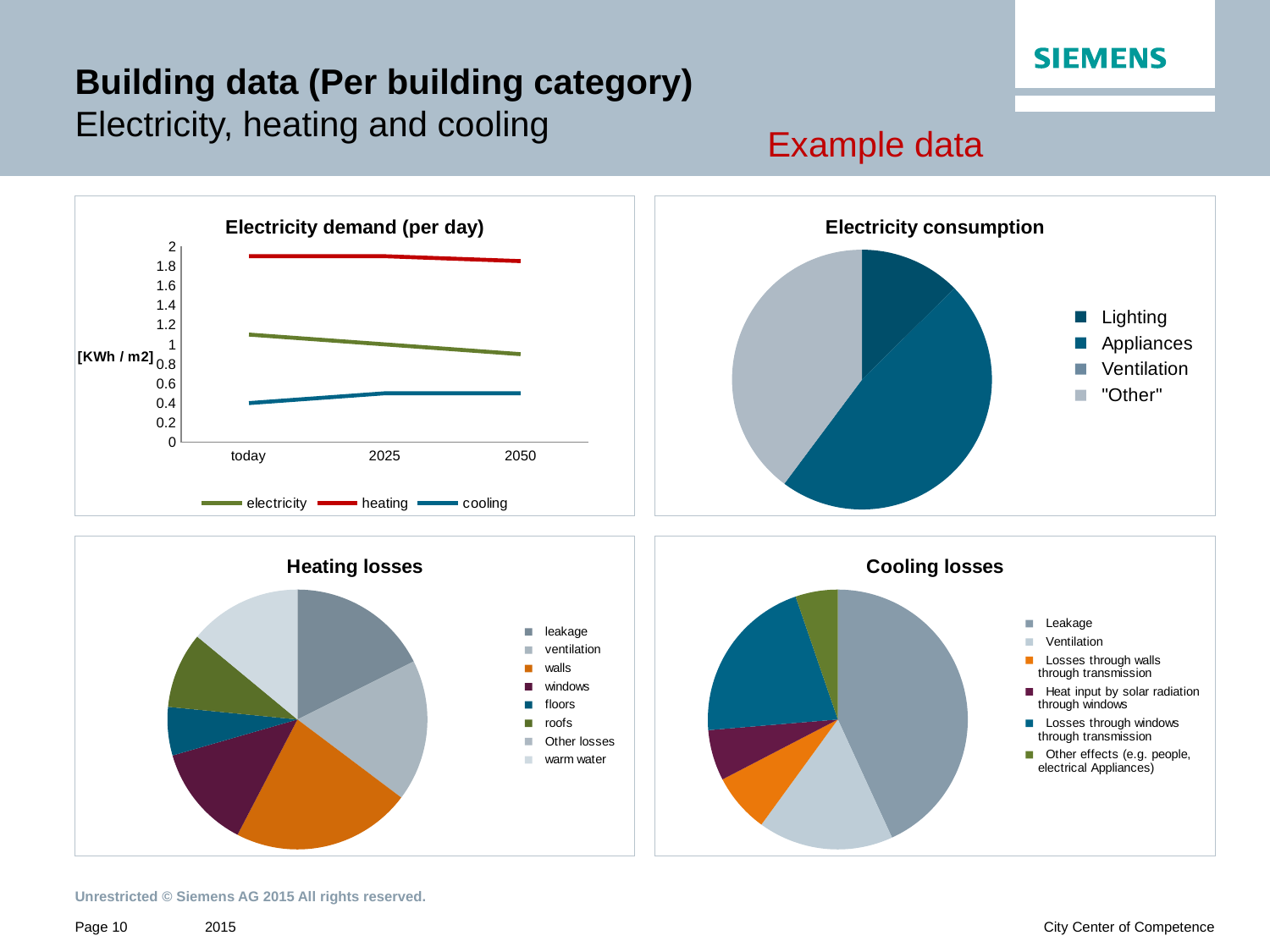
In the 'Cooling losses' pie chart, which category has the largest slice? Leakage In the 'Heating losses' pie chart, how many categories does the legend list? 8 In the 'Electricity demand (per day)' chart, which series has the highest values? heating What kind of chart is the 'Electricity demand (per day)' chart? line chart In the 'Electricity consumption' pie chart, which is larger, Lighting or Appliances? Appliances In the 'Electricity demand (per day)' chart, how many series does the legend list? 3 In the 'Heating losses' pie chart, which category has the smallest slice? floors In the 'Electricity demand (per day)' chart, does the electricity series rise or fall from today to 2050? falls In the 'Electricity demand (per day)' chart, is the value for cooling today greater or less than 0.6? less In the 'Electricity demand (per day)' chart, is the value for heating today greater or less than 1.5? greater In the 'Electricity demand (per day)' chart, which series has the lowest values? cooling In the 'Electricity demand (per day)' chart, how many points are shown on the x axis? 3